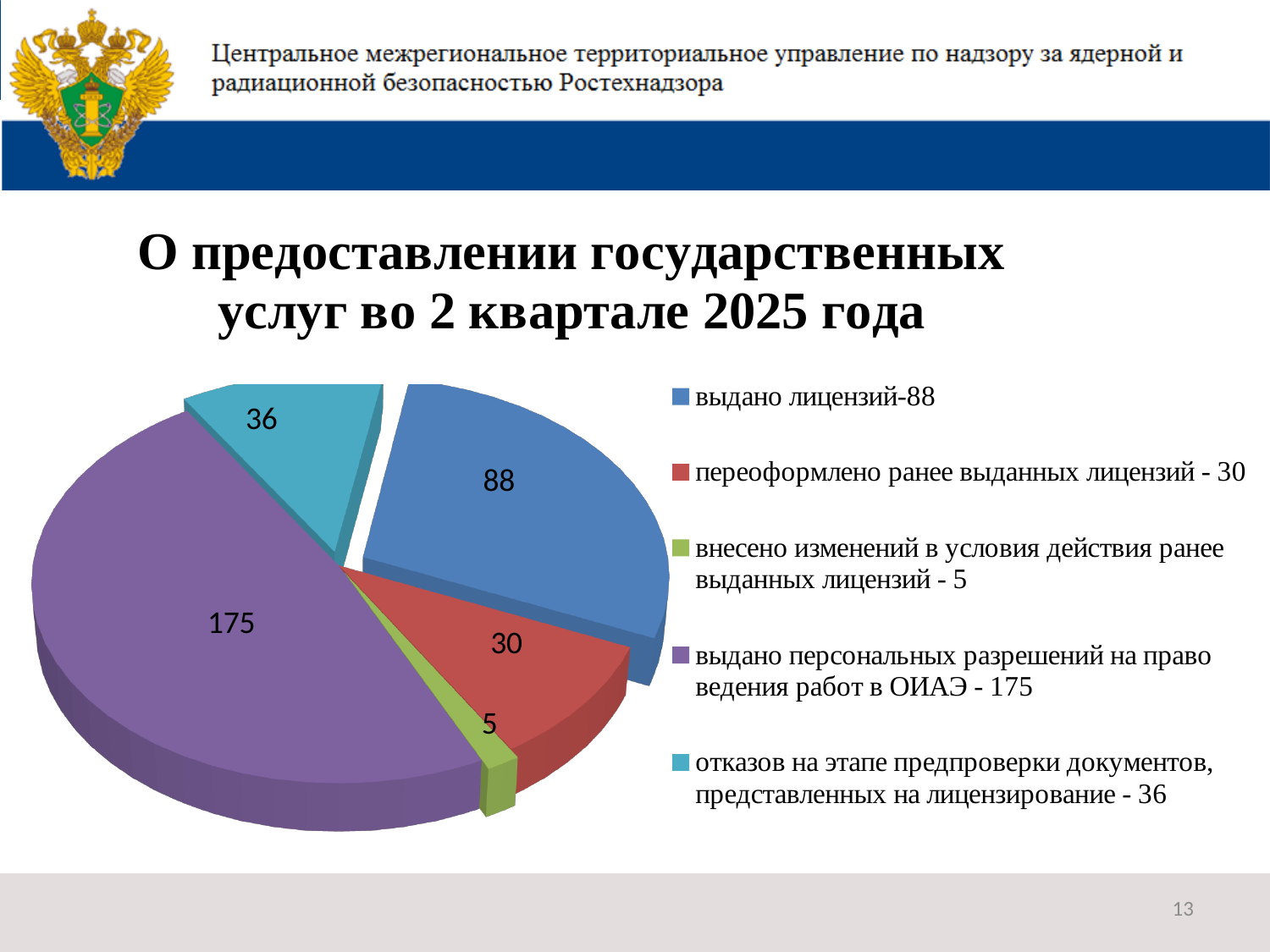
What is the value for "отказов на этапе предпроверки документов, представленных на лицензирование"? 36 Which category has the largest slice of the pie? выдано персональных разрешений на право ведения работ в ОИАЭ How many slices does the pie chart have? 5 What is the value for "выдано лицензий"? 88 What is the total of all the values shown in the pie chart? 334 Which category has the smallest slice of the pie? внесено изменений в условия действия ранее выданных лицензий What colour is the slice for "выдано персональных разрешений на право ведения работ в ОИАЭ"? purple What is the difference between the value for "выдано персональных разрешений на право ведения работ в ОИАЭ" and the value for "выдано лицензий"? 87 How many entries does the legend list? 5 What type of chart is shown on the slide? pie chart What is the value for "переоформлено ранее выданных лицензий"? 30 Which is larger: the value for "отказов на этапе предпроверки документов" or the value for "переоформлено ранее выданных лицензий"? отказов на этапе предпроверки документов